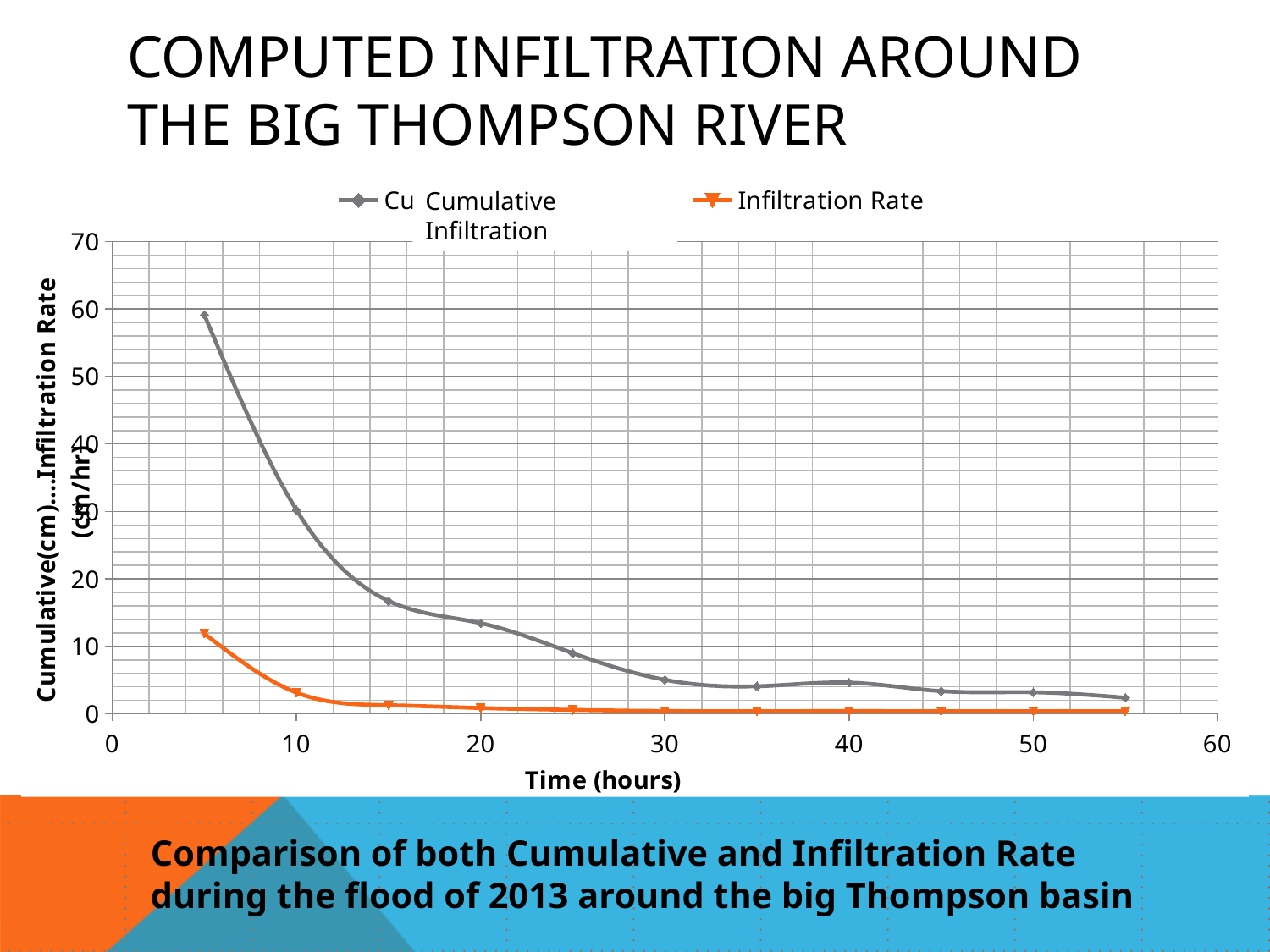
At 10 hours, which series has the larger value, Cumulative Infiltration or Infiltration Rate? Cumulative Infiltration Is the Infiltration Rate value at 5 hours greater or less than 20? less Is the Cumulative Infiltration value at 30 hours greater or less than 10? less What kind of chart is shown on the slide? line chart How many series does the legend list? 2 Does the Infiltration Rate series rise or fall as time increases? fall Is the Cumulative Infiltration value at 10 hours greater or less than 40? less Which series is drawn in orange? Infiltration Rate What is the title of the x axis? Time (hours) Does the Cumulative Infiltration series rise or fall as time increases? fall At what time (in hours) does the Cumulative Infiltration series reach its highest value? 5